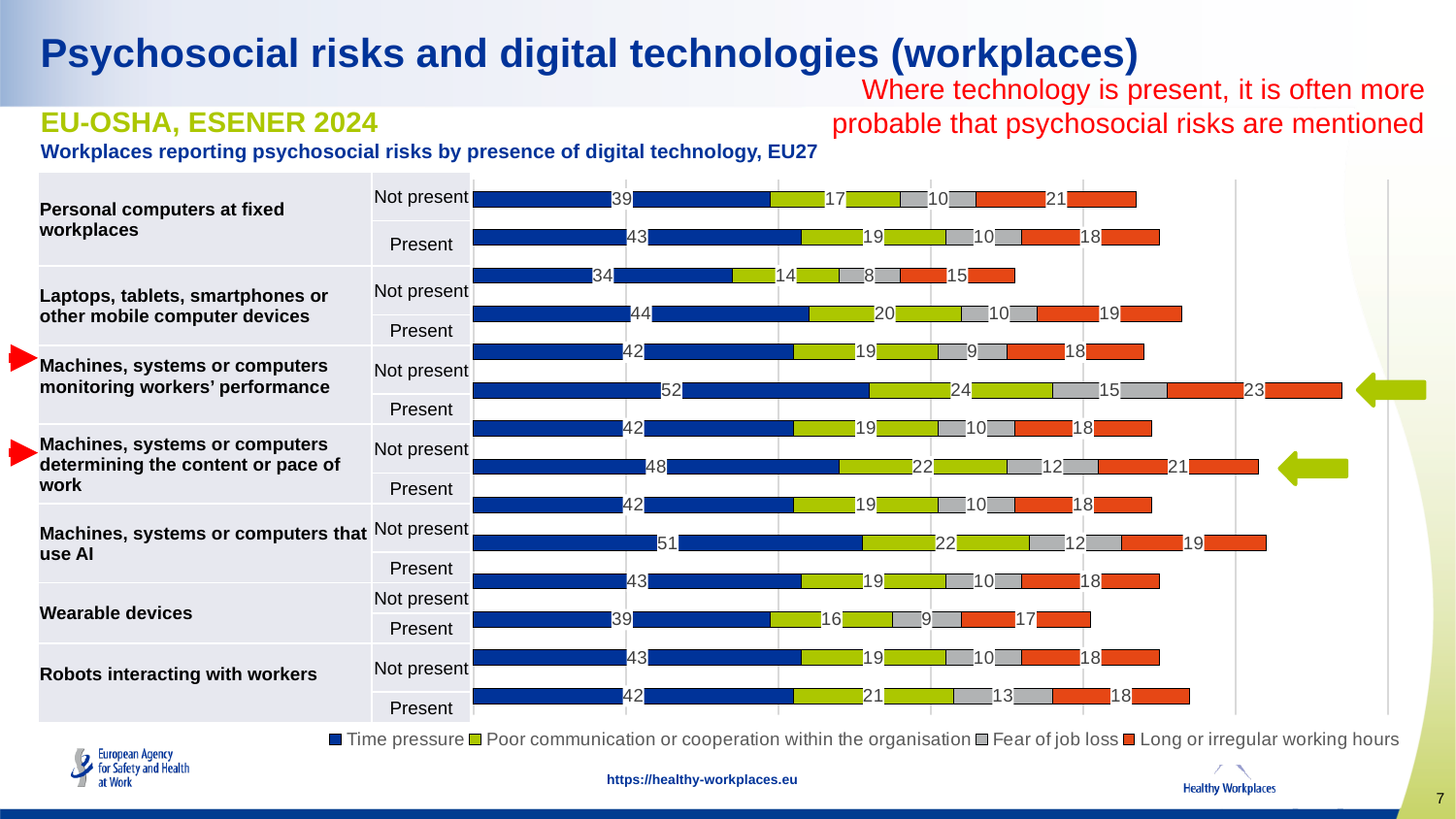
What is the value for long or irregular working hours where wearable devices are present? 17 What percentage of workplaces where machines, systems or computers monitoring workers' performance are present report time pressure? 52 How many series does the legend list? 4 What is the total of the stacked bar for 'Present' under machines, systems or computers monitoring workers' performance? 114 Is the time pressure value higher where robots interacting with workers are present or not present? Not present What kind of chart is shown on the slide? Stacked bar chart Which bar has the highest time pressure value? Machines, systems or computers monitoring workers' performance – Present Which colour represents 'Fear of job loss' in the chart? Grey How many digital technology categories are shown in the chart? 7 What is the difference in time pressure between 'Present' and 'Not present' for machines, systems or computers that use AI? 9 What is the value for fear of job loss where laptops, tablets, smartphones or other mobile computer devices are not present? 8 Which bar has the lowest time pressure value? Laptops, tablets, smartphones or other mobile computer devices – Not present